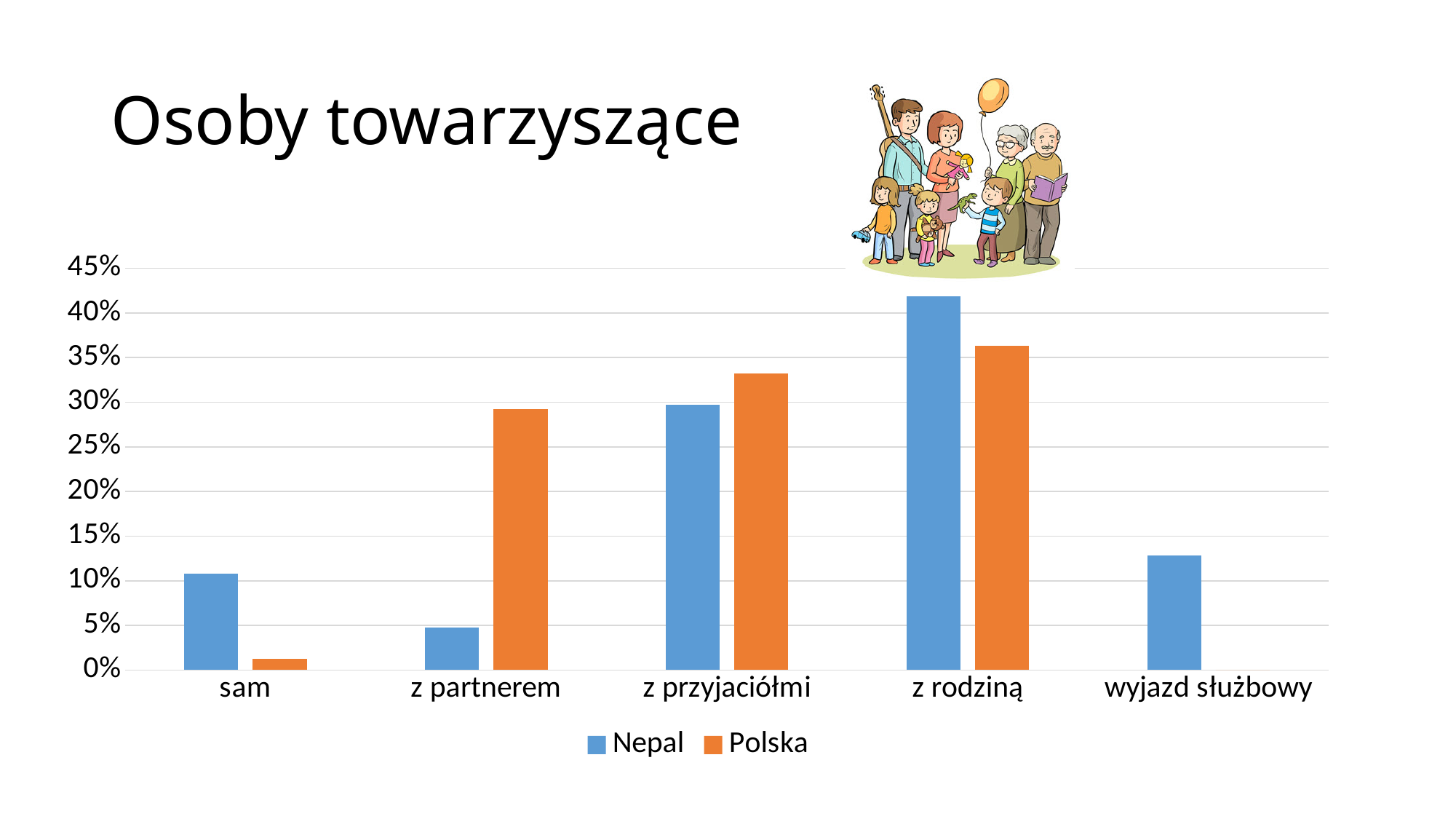
Is the value for Nepal in the 'z rodziną' category greater or less than 35%? greater Which category has the highest value for Nepal? z rodziną How many series does the legend list? 2 Is the value for Polska in the 'sam' category greater or less than 5%? less Which category has the lowest value for Nepal? z partnerem What kind of chart is shown on the slide? bar chart What is the title of the slide? Osoby towarzyszące Is the value for Nepal in the 'z partnerem' category greater or less than 10%? less Which category has the highest value for Polska? z rodziną How many categories are shown on the x axis? 5 In the 'z partnerem' category, which series has the larger value, Nepal or Polska? Polska